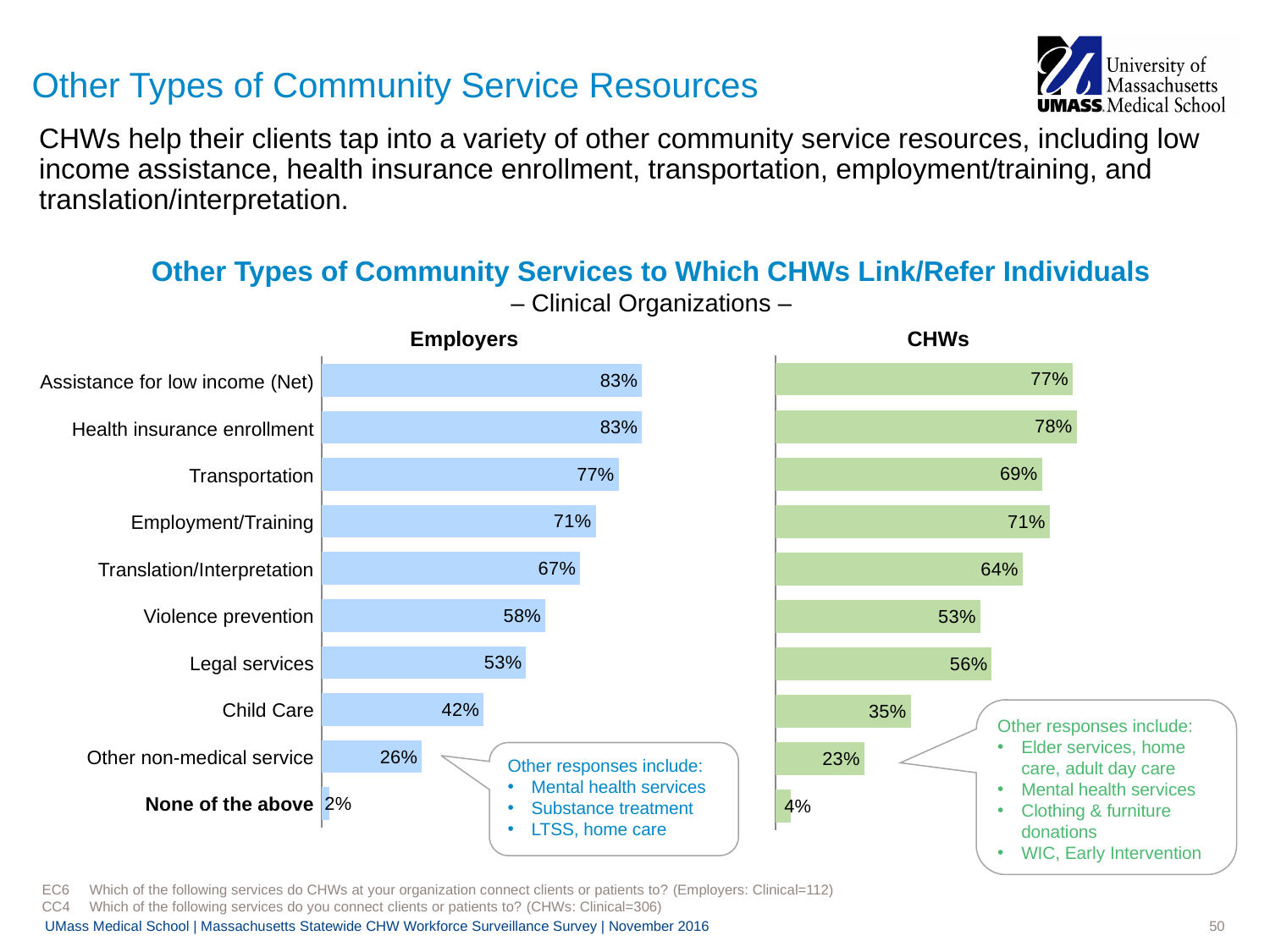
In the Employers chart, what percentage is shown for Other non-medical service? 26% In the CHWs chart, which category has the lowest value? None of the above In the Employers chart, what percentage is shown for Transportation? 77% What is the difference between the Employers and CHWs values for Violence prevention? 5% In the CHWs chart, what percentage is shown for Legal services? 56% What is the title of the chart on the slide? Other Types of Community Services to Which CHWs Link/Refer Individuals In the CHWs chart, which category has the highest value? Health insurance enrollment Which is larger for Translation/Interpretation: the Employers value or the CHWs value? Employers In the CHWs chart, what percentage is shown for Child Care? 35% What type of chart is used to show the Employers data? Bar chart In the Employers chart, which category has the lowest value? None of the above How many categories are shown in the Employers chart? 10